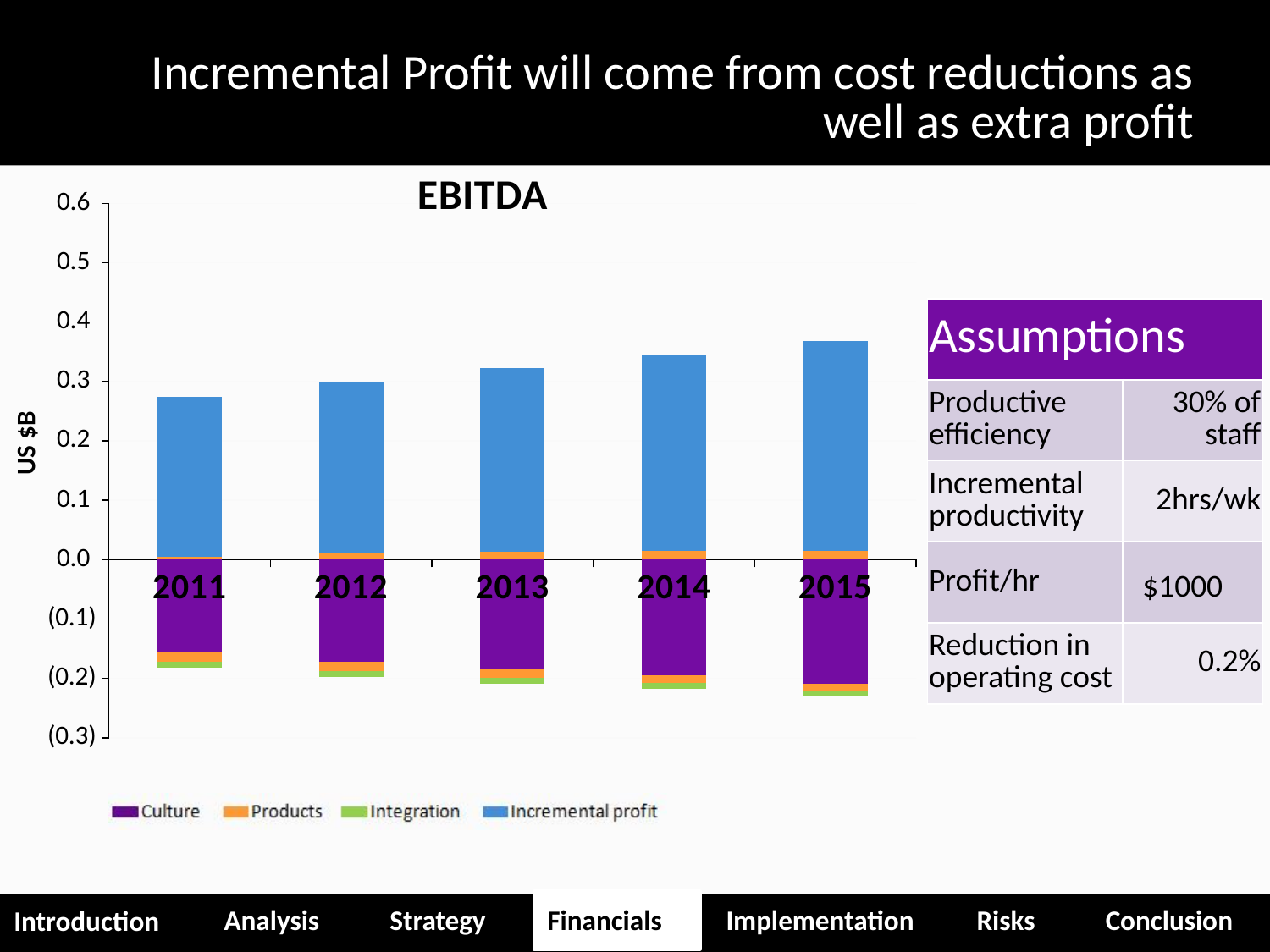
What is the title of the chart? EBITDA Is the Incremental profit value for 2015 greater or less than 0.3? greater What kind of chart is the EBITDA chart? stacked bar chart Is the Incremental profit value for 2011 greater or less than 0.3? less What is the label on the vertical axis of the chart? US $B Which year has the larger Incremental profit bar, 2011 or 2015? 2015 Is the Incremental profit value for 2014 greater or less than 0.3? greater Does the Incremental profit series rise or fall from 2011 to 2015? rise How many series does the legend of the EBITDA chart list? 4 Which year has the highest Incremental profit bar in the EBITDA chart? 2015 How many years are shown on the x axis of the EBITDA chart? 5 Which year has the lowest Incremental profit bar in the EBITDA chart? 2011